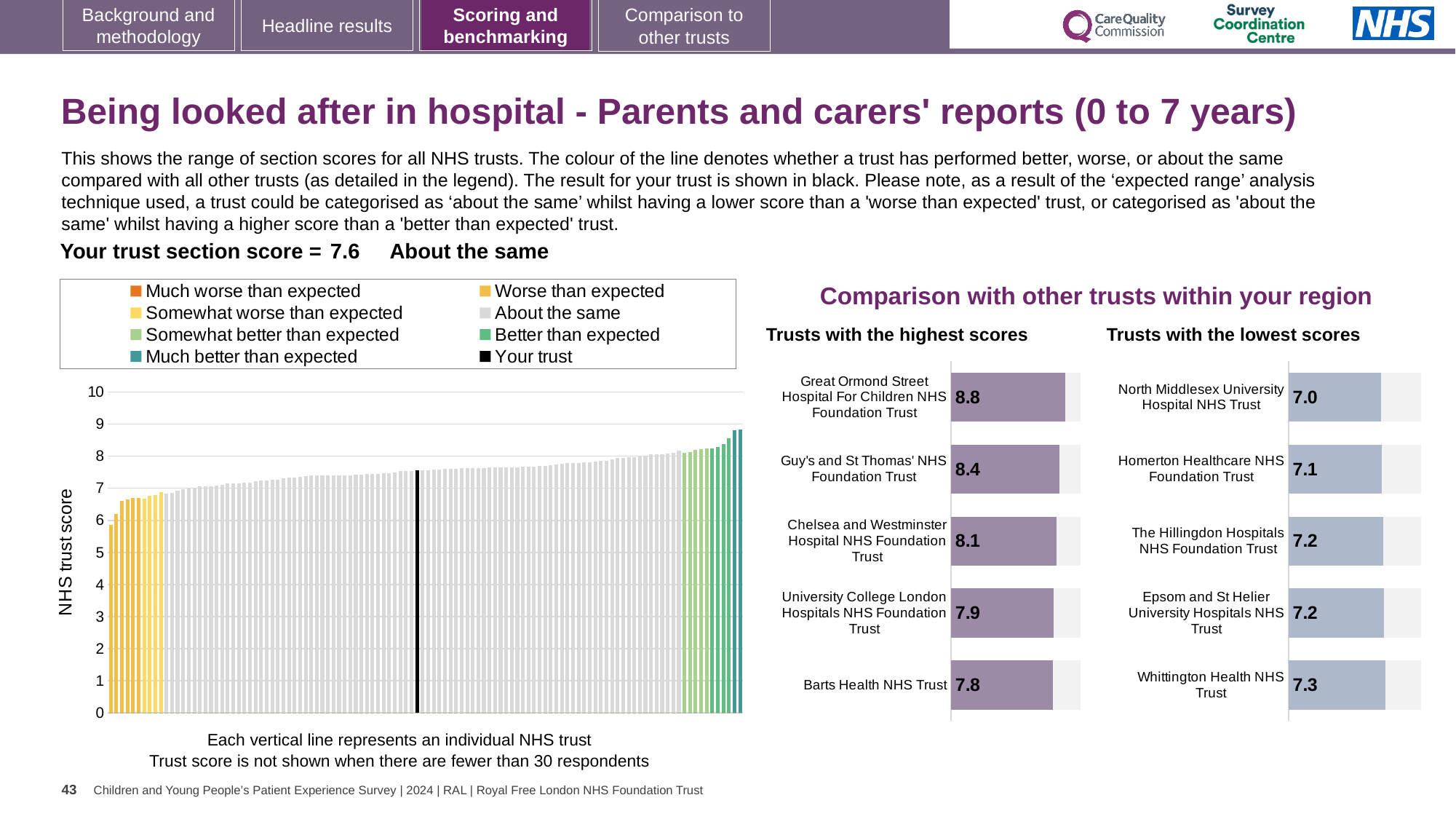
What kind of chart is the main chart showing the range of section scores for all NHS trusts? bar chart How many trusts are listed in the 'Trusts with the highest scores' chart? 5 In the 'Trusts with the lowest scores' chart, what is the score for Homerton Healthcare NHS Foundation Trust? 7.1 In the 'Trusts with the lowest scores' chart, what is the difference between the scores of Whittington Health NHS Trust and North Middlesex University Hospital NHS Trust? 0.3 What is the y-axis label of the main chart of all NHS trusts? NHS trust score In the 'Trusts with the highest scores' chart, which has the higher score: Chelsea and Westminster Hospital NHS Foundation Trust or University College London Hospitals NHS Foundation Trust? Chelsea and Westminster Hospital NHS Foundation Trust In the 'Trusts with the highest scores' chart, which trust has the highest score? Great Ormond Street Hospital For Children NHS Foundation Trust In the 'Trusts with the highest scores' chart, what is the score for Great Ormond Street Hospital For Children NHS Foundation Trust? 8.8 How many entries does the legend of the main chart of all NHS trusts list? 8 In the 'Trusts with the lowest scores' chart, which trust has the lowest score? North Middlesex University Hospital NHS Trust In the main chart of all NHS trusts, what is the section score for your trust (shown in black)? 7.6 In the 'Trusts with the highest scores' chart, what is the difference between the scores of Great Ormond Street Hospital For Children NHS Foundation Trust and Barts Health NHS Trust? 1.0